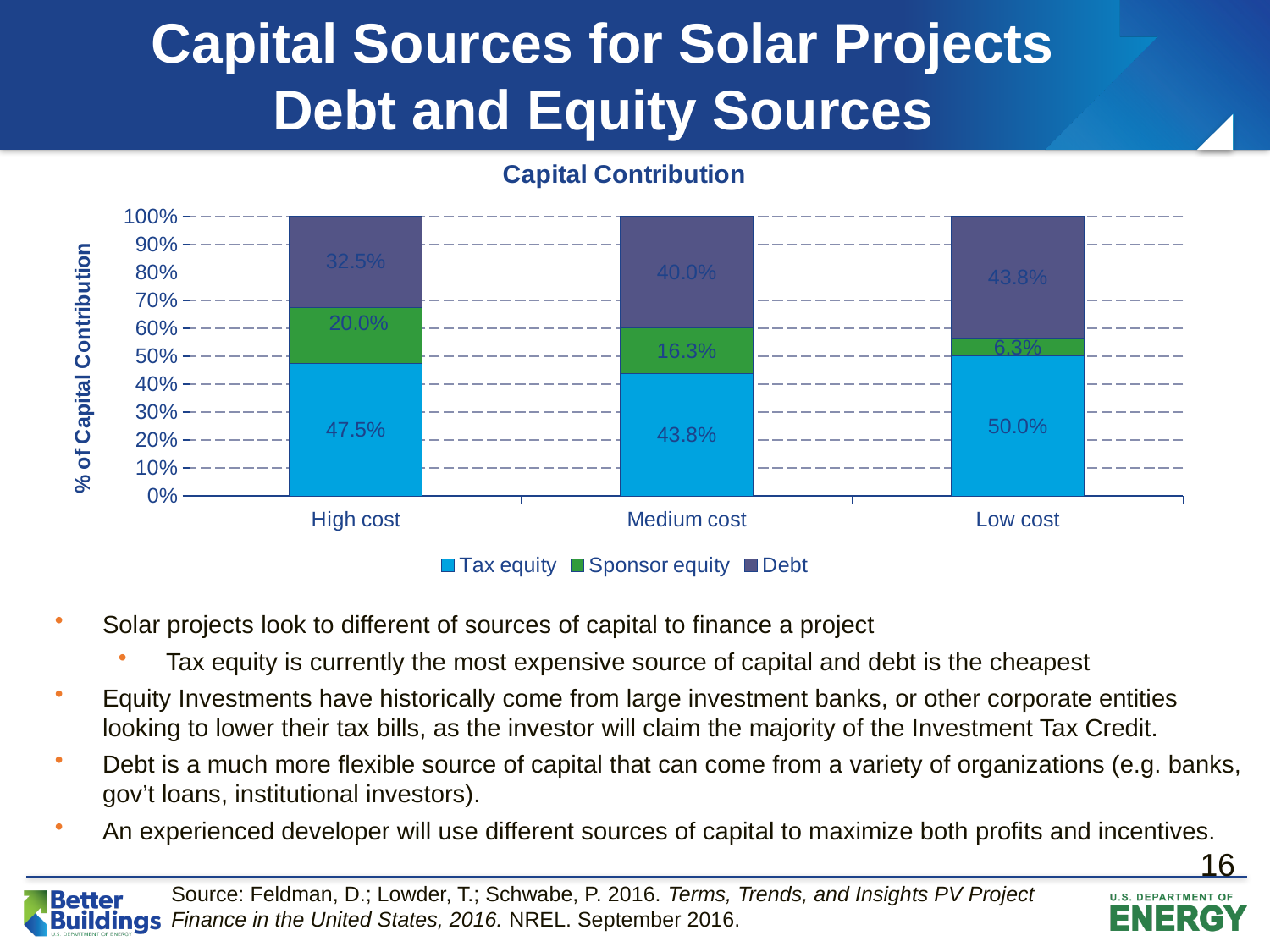
Does the Debt share rise or fall from High cost to Low cost? Rise What is the Sponsor equity share for Medium cost? 16.3% Which cost category has the highest Debt share? Low cost How many cost categories are shown on the x axis? 3 What kind of chart is shown? Stacked bar chart What is the title of the chart? Capital Contribution Which is larger: the Tax equity share for Low cost or the Tax equity share for Medium cost? Low cost Which cost category has the lowest Sponsor equity share? Low cost How many series does the legend list? 3 What is the Tax equity share for High cost? 47.5% What is the Debt share for Low cost? 43.8% What is the difference between the Debt share for Low cost and the Debt share for High cost? 11.3%